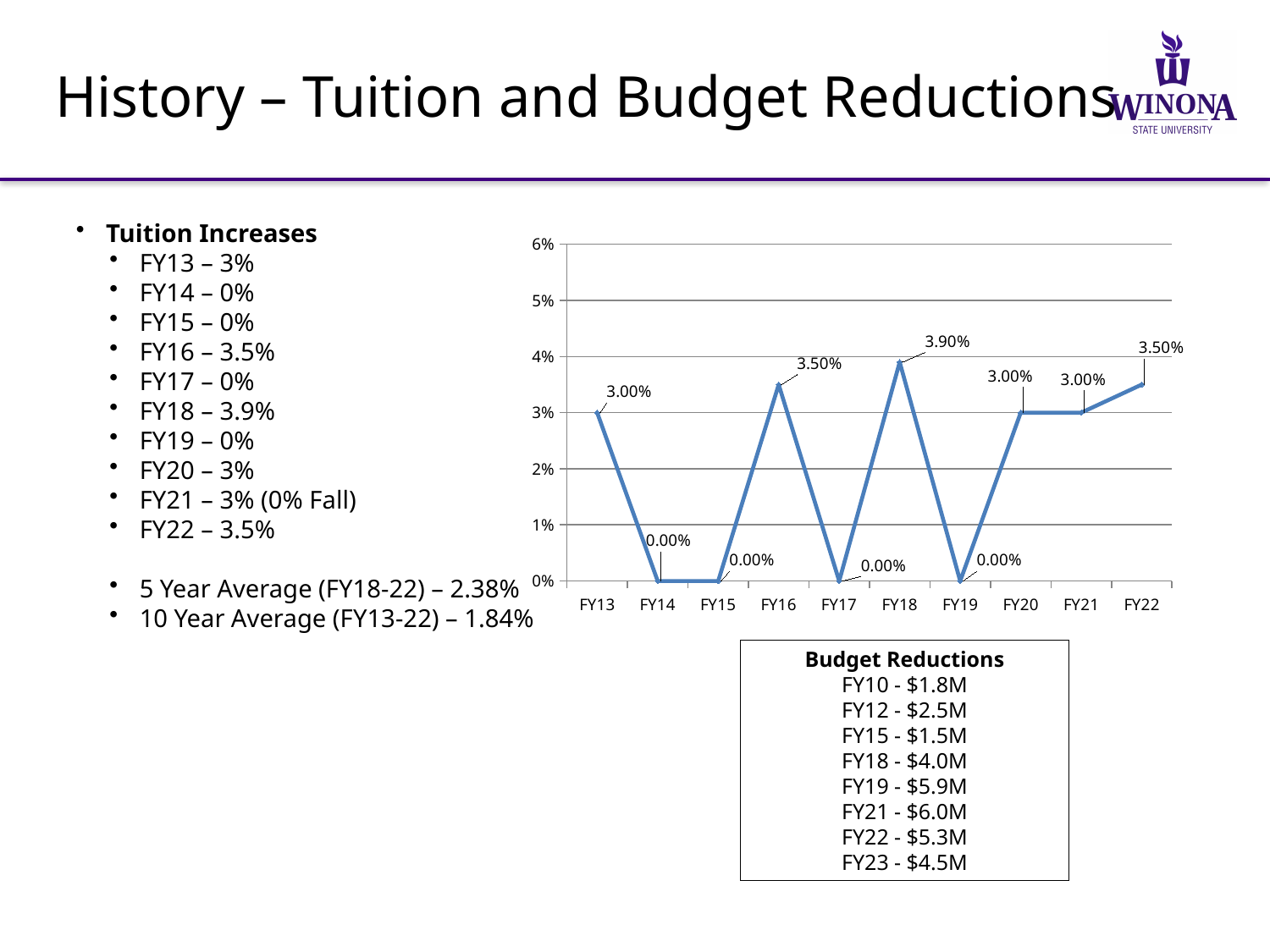
Is the value for FY18 greater or less than 3%? greater What is the value for FY13 on the chart? 3.00% Which is larger, the value for FY18 or the value for FY21? FY18 How many fiscal years are plotted on the chart? 10 Which fiscal year has the highest value on the chart? FY18 What is the difference between the values for FY18 and FY22? 0.40% What is the difference between the values for FY16 and FY20? 0.50% How many fiscal years on the chart have a value of 0.00%? 4 What is the value for FY16 on the chart? 3.50% What kind of chart is shown on the slide? line chart What is the value for FY19 on the chart? 0.00% What is the value for FY18 on the chart? 3.90%